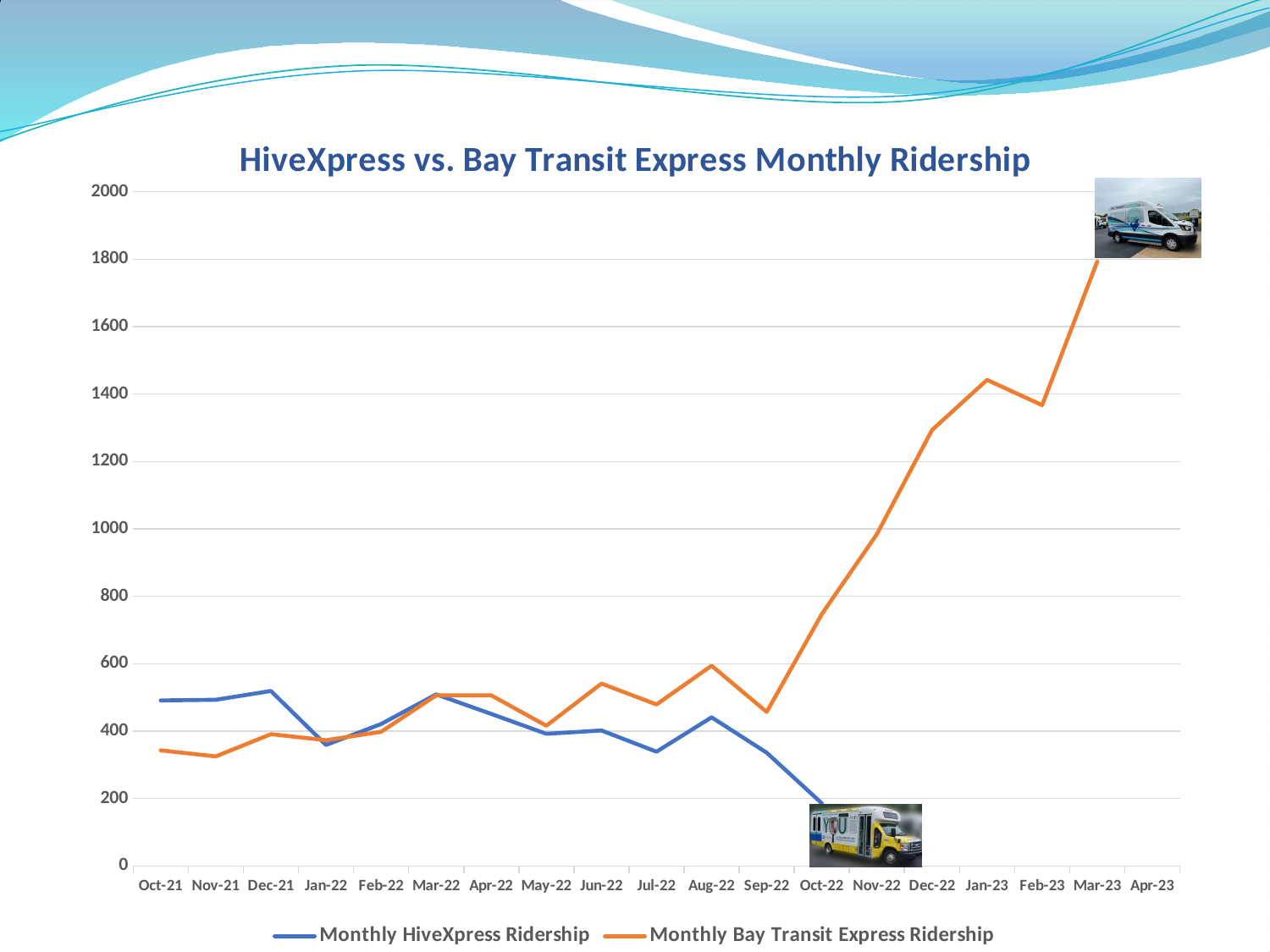
Which series is drawn in orange? Monthly Bay Transit Express Ridership How many series does the legend list? 2 In Oct-21, which series has the larger value, Monthly HiveXpress Ridership or Monthly Bay Transit Express Ridership? Monthly HiveXpress Ridership What is the title of the chart? HiveXpress vs. Bay Transit Express Monthly Ridership Is the value for Monthly HiveXpress Ridership in Dec-21 greater or less than 400? greater In which month does Monthly Bay Transit Express Ridership reach its highest value? Mar-23 In which month is Monthly HiveXpress Ridership at its lowest? Oct-22 What kind of chart is shown on the slide? line chart Does Monthly Bay Transit Express Ridership rise or fall from Sep-22 to Mar-23? rise How many month labels are shown on the x axis? 19 Is the value for Monthly Bay Transit Express Ridership in Mar-23 greater or less than 1600? greater Is the value for Monthly Bay Transit Express Ridership in Oct-21 greater or less than 400? less